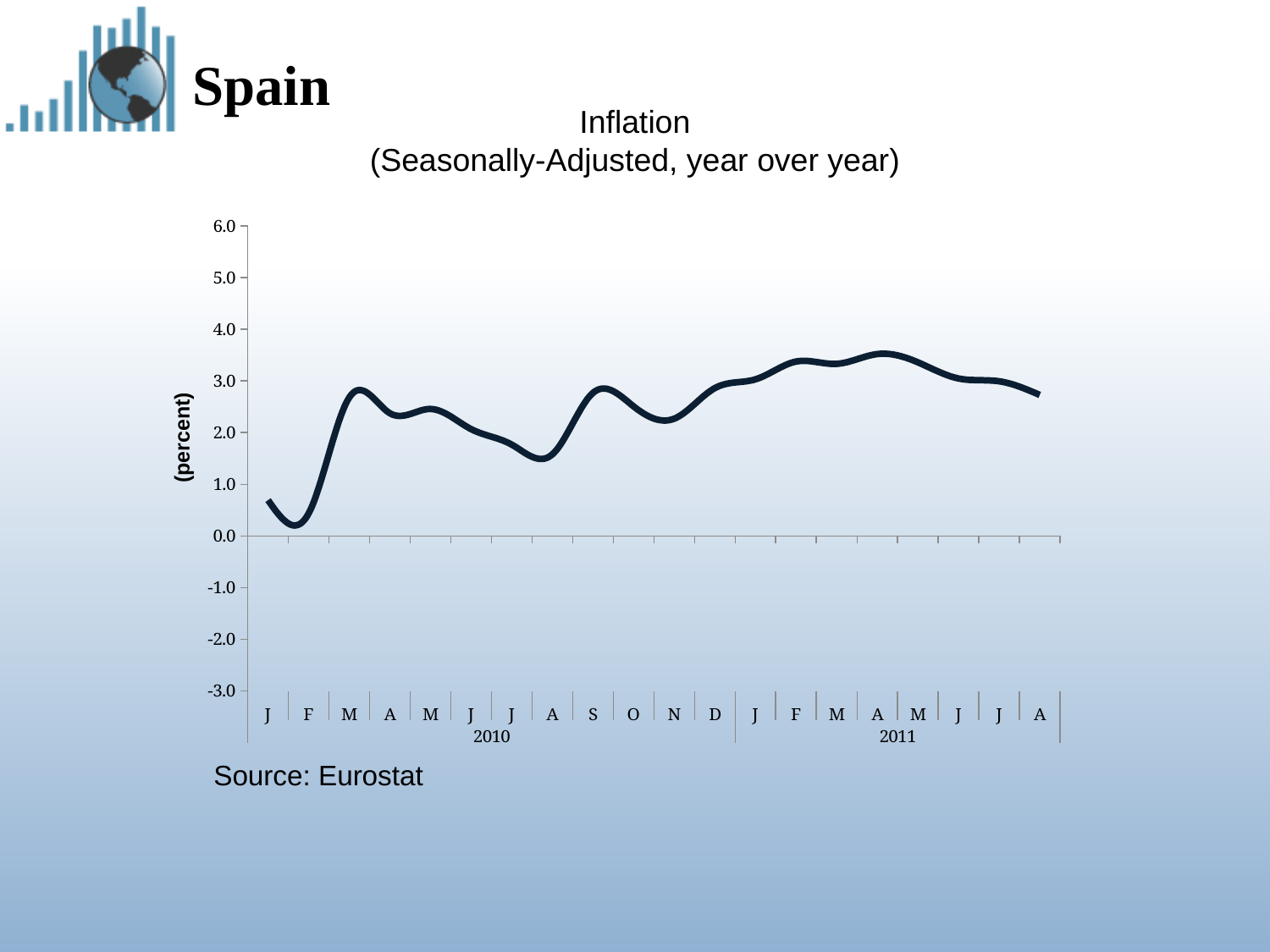
Is the inflation value for August 2010 greater or less than 2.0? less Is the inflation value for April 2011 greater or less than 3.0? greater Is the inflation value for August 2011 greater or less than 2.0? greater Does inflation rise or fall from May 2011 to August 2011? fall What is the label on the vertical axis of the chart? (percent) How many monthly data points are plotted on the chart? 20 What is the title of the chart? Inflation (Seasonally-Adjusted, year over year) Which is larger, the inflation value for August 2010 or for September 2010? September 2010 Which is larger, the inflation value for February 2010 or for April 2011? April 2011 What kind of chart is shown on the slide? line chart Which month has the lowest inflation value on the chart? February 2010